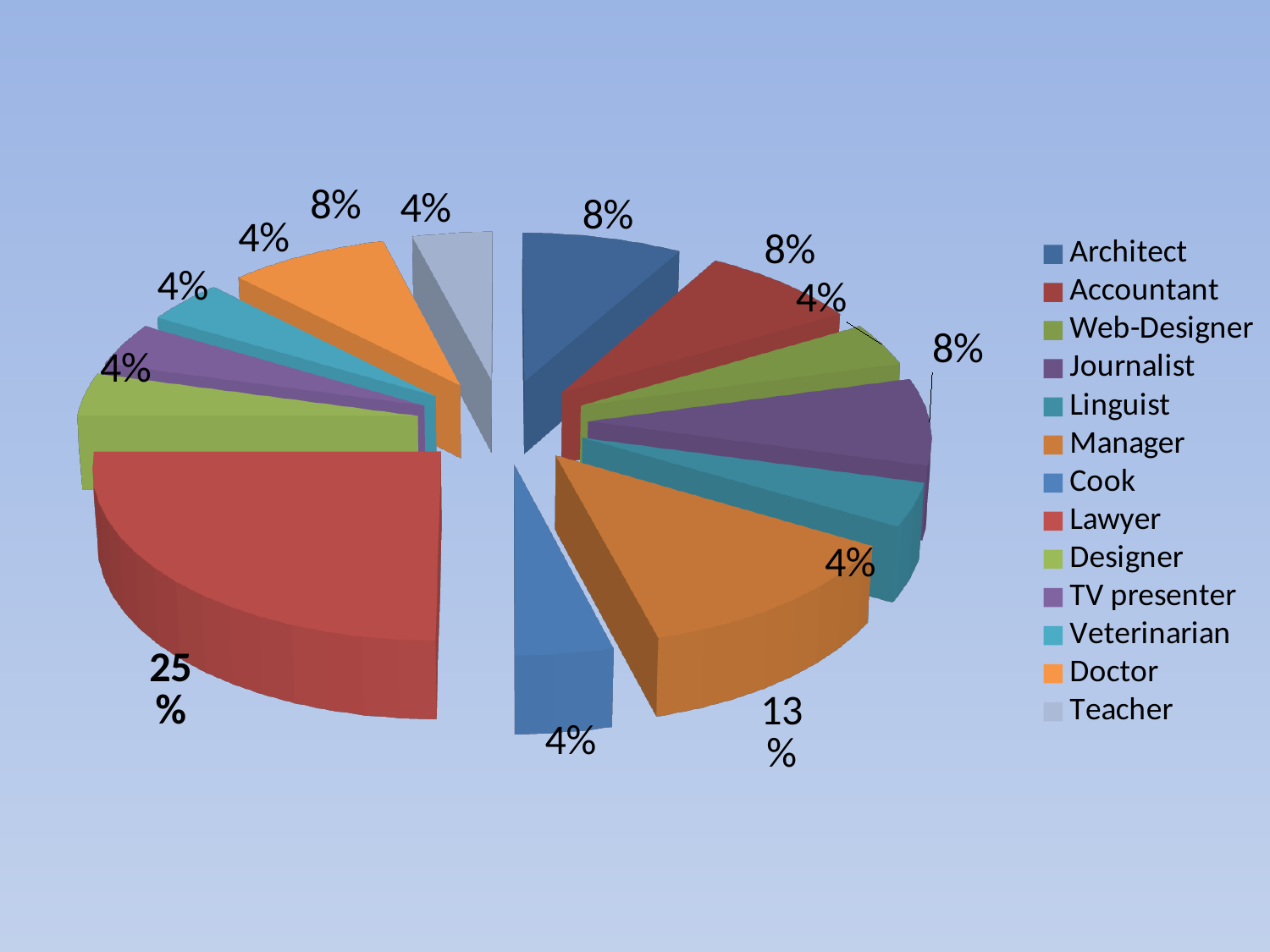
What percentage is shown for the Architect slice? 8% Which category is listed last in the legend of the pie chart? Teacher Which category has the largest slice of the pie chart? Lawyer What is the difference in percentage points between the Lawyer slice and the Manager slice? 12 What percentage is shown for the Lawyer slice? 25% Which is larger, the Manager slice or the Architect slice? Manager What is the difference in percentage points between the Manager slice and the Cook slice? 9 What percentage is shown for the Teacher slice? 4% How many categories does the legend of the pie chart list? 13 What percentage is shown for the Manager slice? 13% What kind of chart is shown on the slide? pie chart Which is larger, the Lawyer slice or the Manager slice? Lawyer